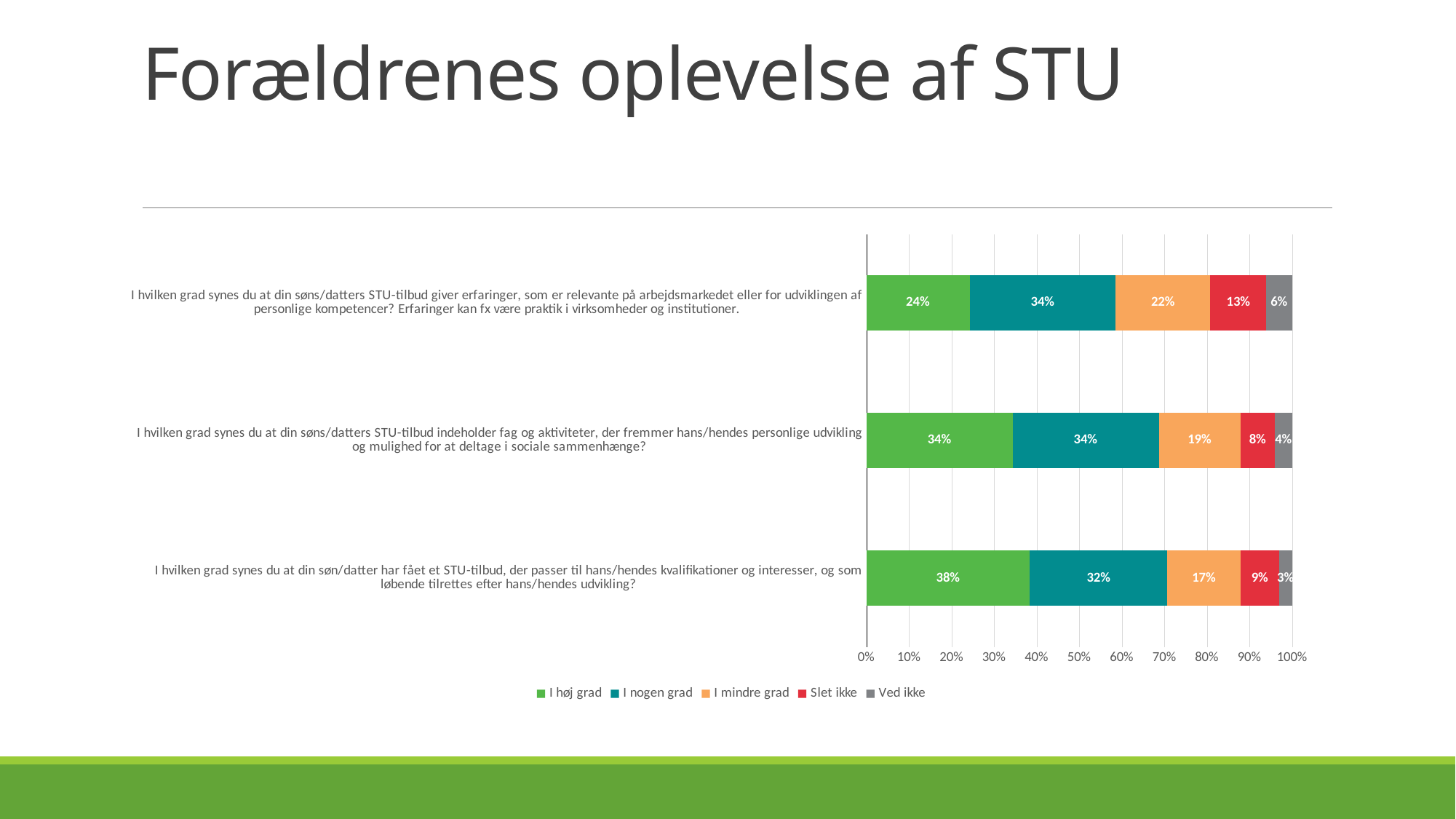
Which legend entry is shown in red? Slet ikke What is the difference between the 'I høj grad' values of the bottom bar and the top bar? 14 percentage points What is the 'Slet ikke' value for the top bar (the question about experiences relevant to the labour market)? 13% What kind of chart is shown on the slide? Stacked bar chart How many questions (bars) are plotted in the chart? 3 Which question has the lowest 'Ved ikke' share? I hvilken grad synes du at din søn/datter har fået et STU-tilbud, der passer til hans/hendes kvalifikationer og interesser, og som løbende tilrettes efter hans/hendes udvikling? What is the 'I høj grad' value for the bottom bar (the question about whether the STU offer fits the son's/daughter's qualifications and interests)? 38% What is the total of the labelled segments in the middle bar? 99% Which question has the highest 'I høj grad' share? I hvilken grad synes du at din søn/datter har fået et STU-tilbud, der passer til hans/hendes kvalifikationer og interesser, og som løbende tilrettes efter hans/hendes udvikling? What is the 'I mindre grad' value for the middle bar (the question about subjects and activities promoting personal development)? 19% Is the 'Slet ikke' value larger for the top bar or the middle bar? The top bar How many series does the legend list? 5